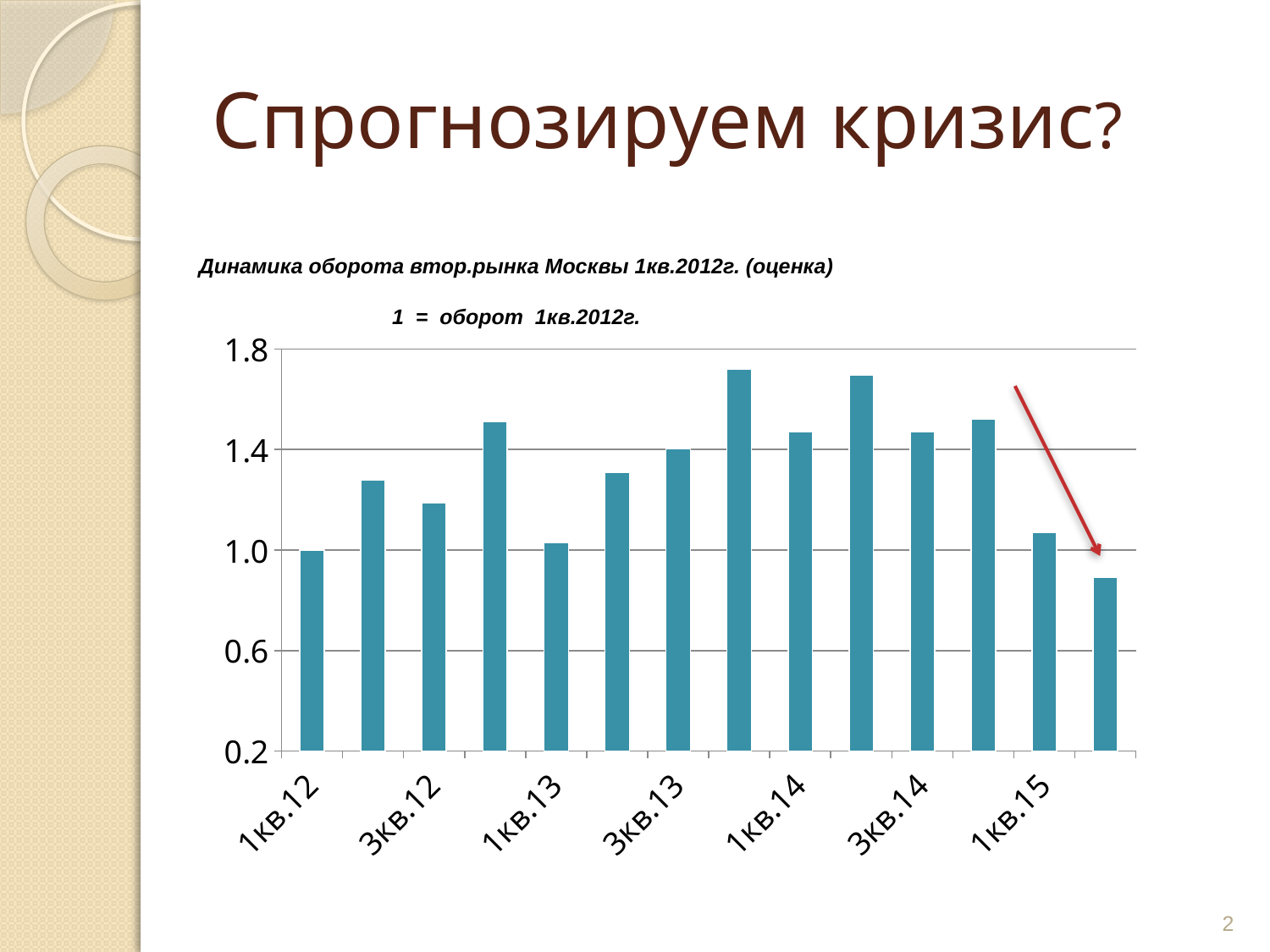
Is the value for 3кв.12 greater or less than 1.0? greater Is the value for 1кв.14 greater or less than 1.4? greater What is the title of the chart? Динамика оборота втор.рынка Москвы 1кв.2012г. (оценка) What colour are the bars in the chart? Teal blue Which is larger, the value for 3кв.12 or the value for 1кв.13? 3кв.12 Is the value for 1кв.13 greater or less than 1.4? less Do the values rise or fall from 3кв.14 to 1кв.15? fall Which is larger, the value for 1кв.14 or the value for 1кв.15? 1кв.14 How many bars are plotted in the chart? 14 What is the value for 1кв.12? 1.0 What kind of chart is shown on the slide? Bar chart